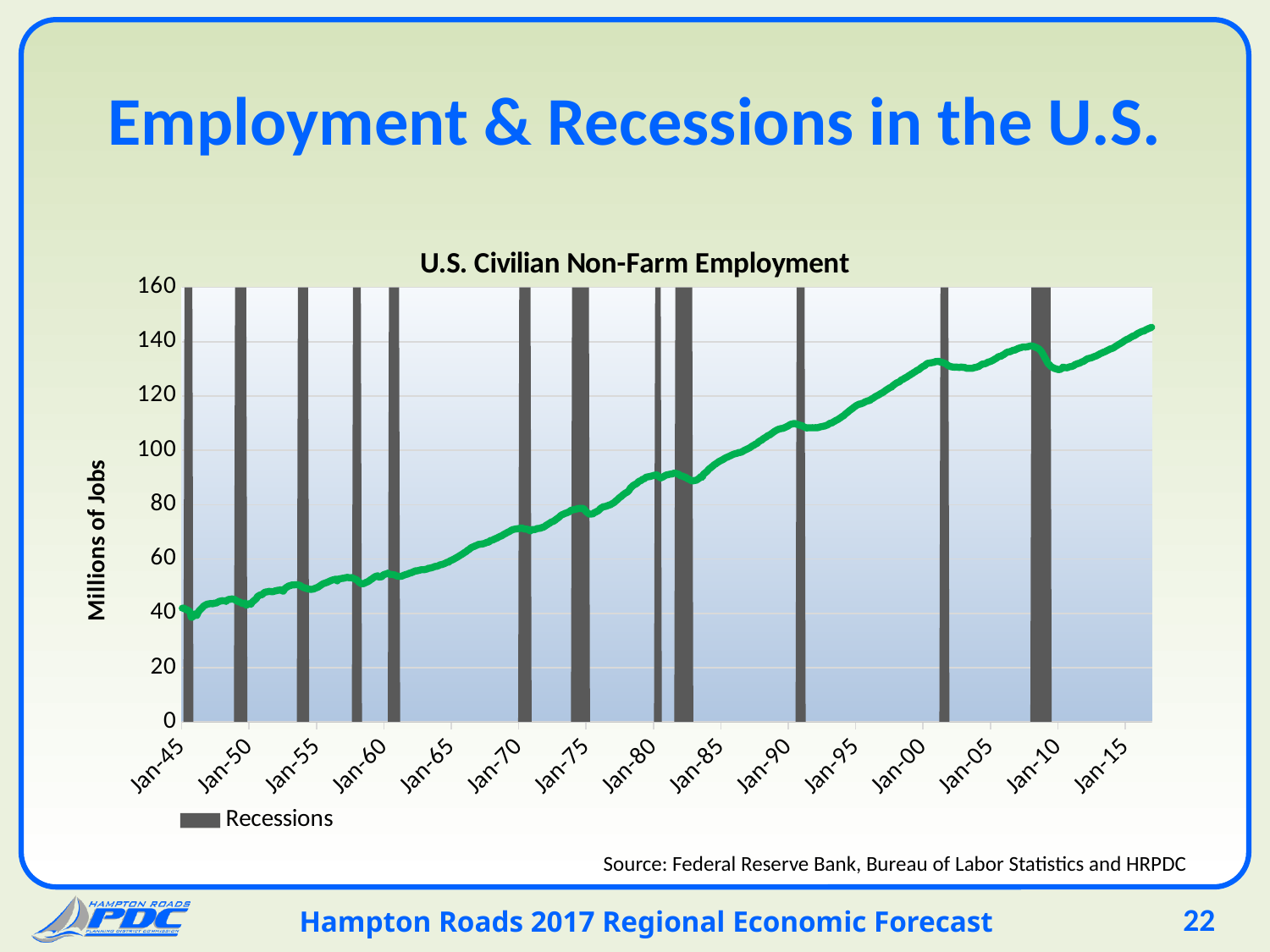
Is the employment value at Jan-00 greater or less than 120 million jobs? greater Is the employment value at Jan-90 greater or less than 100 million jobs? greater Around which labelled year does the employment line reach its highest point? Jan-15 Which is larger, the employment value at Jan-90 or at Jan-70? Jan-90 What kind of chart is used to show U.S. Civilian Non-Farm Employment? line chart What is the label on the vertical axis of the chart? Millions of Jobs Is the employment value at Jan-70 greater or less than 60 million jobs? greater Around which labelled year does the employment line reach its lowest point? Jan-45 Overall, does employment rise or fall from Jan-45 to Jan-15 in the chart? rise What is the title of the chart? U.S. Civilian Non-Farm Employment